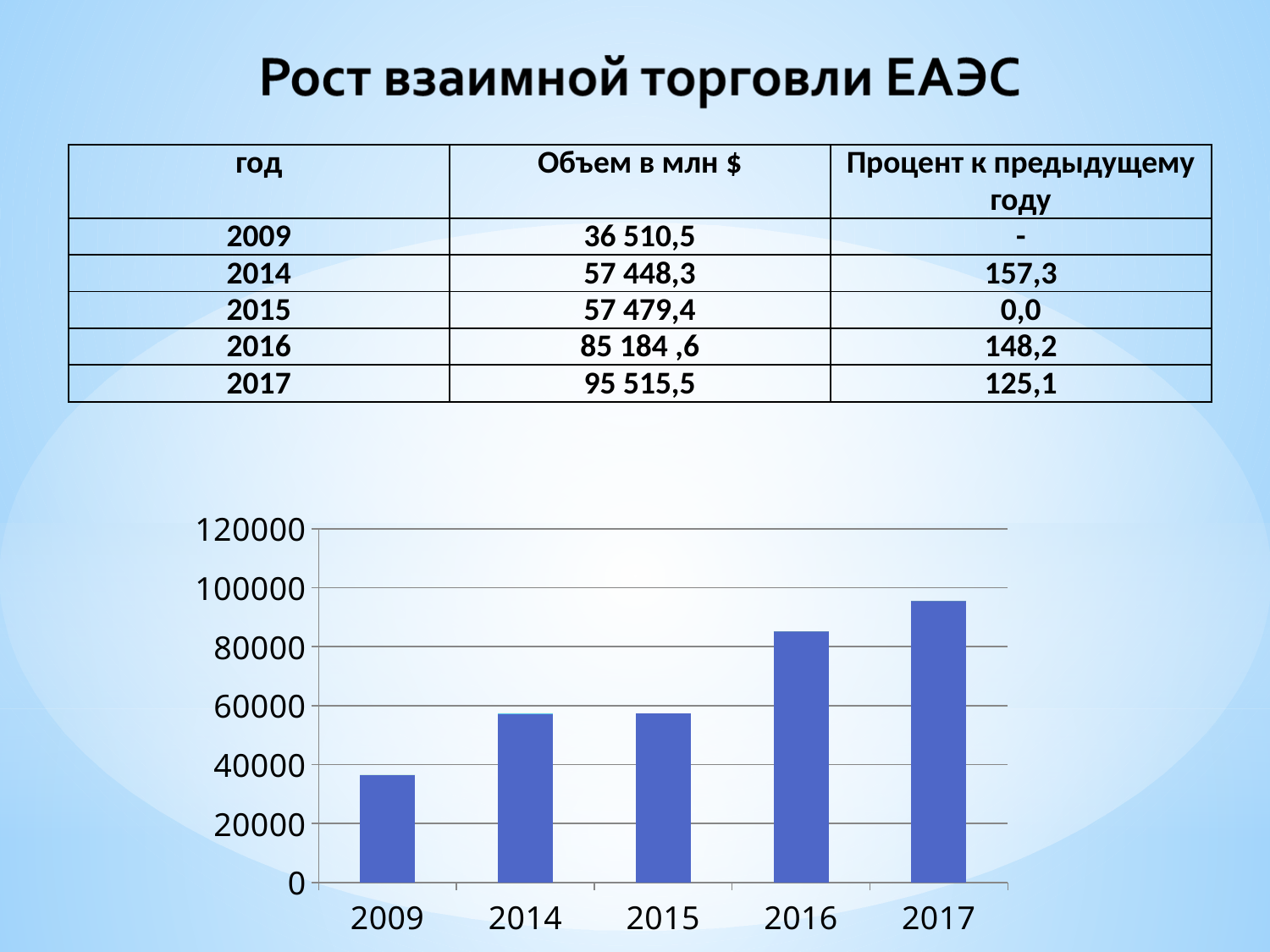
What kind of chart is shown on the slide? bar chart Is the value for 2014 greater or less than 40000? greater Which year has the lowest bar in the chart? 2009 How many bars (years) does the chart show? 5 Is the value for 2016 greater or less than 80000? greater Which year has the highest bar in the chart? 2017 Do the values generally rise or fall from 2009 to 2017? rise Which is larger, the bar for 2016 or the bar for 2015? 2016 What is the title of the slide containing the chart? Рост взаимной торговли ЕАЭС What is the highest value shown on the vertical axis of the chart? 120000 Is the value for 2017 greater or less than 100000? less